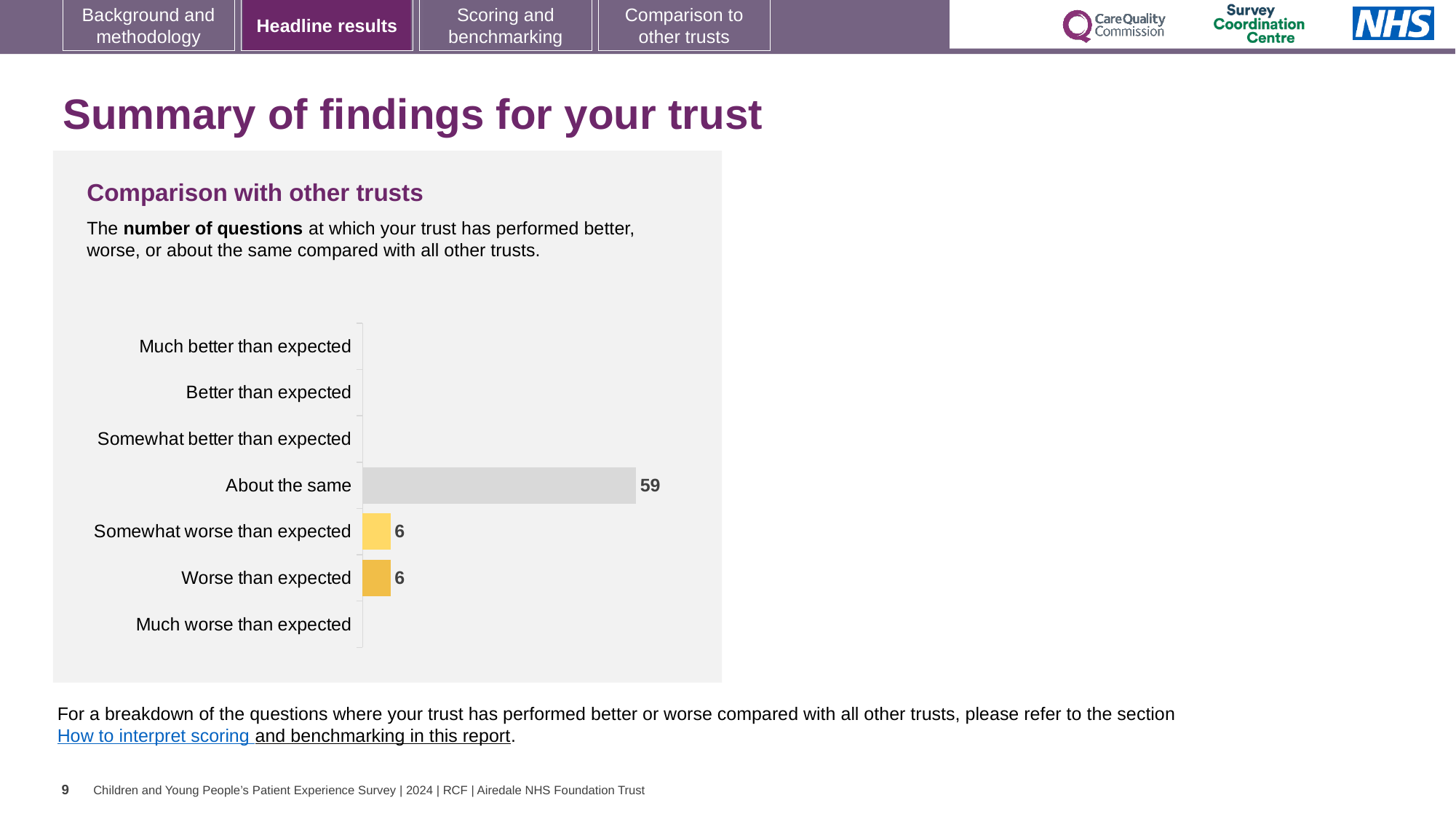
How many categories are listed on the chart's vertical axis? 7 What is the difference between the values for "About the same" and "Worse than expected"? 53 Which category has the highest value? About the same Is the value for "About the same" greater or less than 50? greater Which is larger, the value for "About the same" or the value for "Somewhat worse than expected"? About the same What kind of chart is shown on the slide? bar chart What colour is the bar for "About the same"? grey What is the title of the chart? Comparison with other trusts What is the value for "Somewhat worse than expected"? 6 What is the difference between the values for "About the same" and "Somewhat worse than expected"? 53 What is the value for "About the same"? 59 What is the value for "Worse than expected"? 6